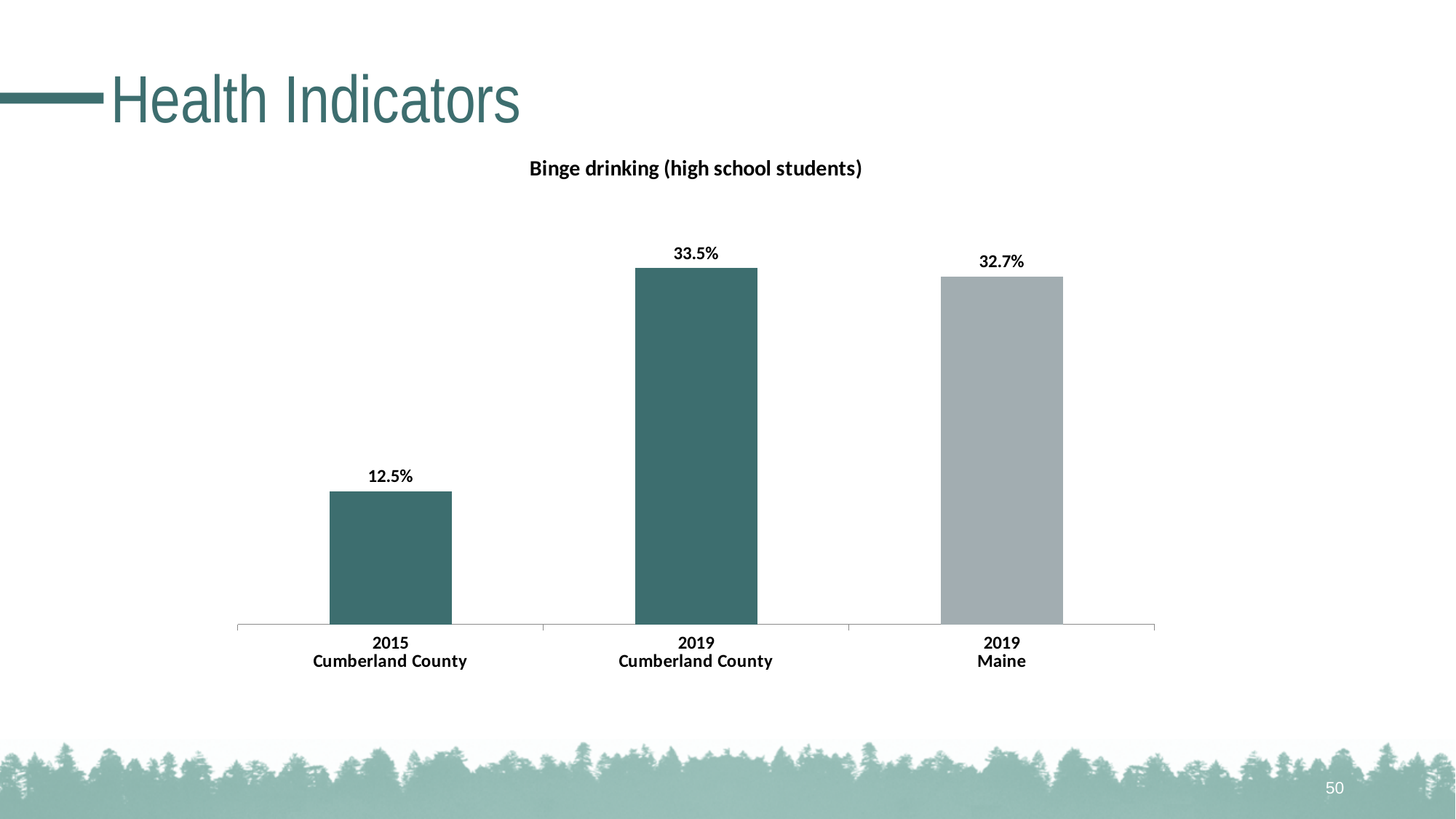
What is the difference between the 2019 Cumberland County value and the 2019 Maine value? 0.8% What is the title of the chart? Binge drinking (high school students) What is the difference between the 2019 Cumberland County value and the 2015 Cumberland County value? 21.0% Which is larger, the value for 2015 Cumberland County or the value for 2019 Maine? 2019 Maine Did the binge drinking rate for Cumberland County rise or fall from 2015 to 2019? Rise What is the binge drinking value for 2015 Cumberland County? 12.5% How many bars are shown in the chart? 3 Which category has the lowest binge drinking value? 2015 Cumberland County What is the binge drinking value for 2019 Maine? 32.7% What is the binge drinking value for 2019 Cumberland County? 33.5% Which category has the highest binge drinking value? 2019 Cumberland County What kind of chart is shown on the slide? Bar chart